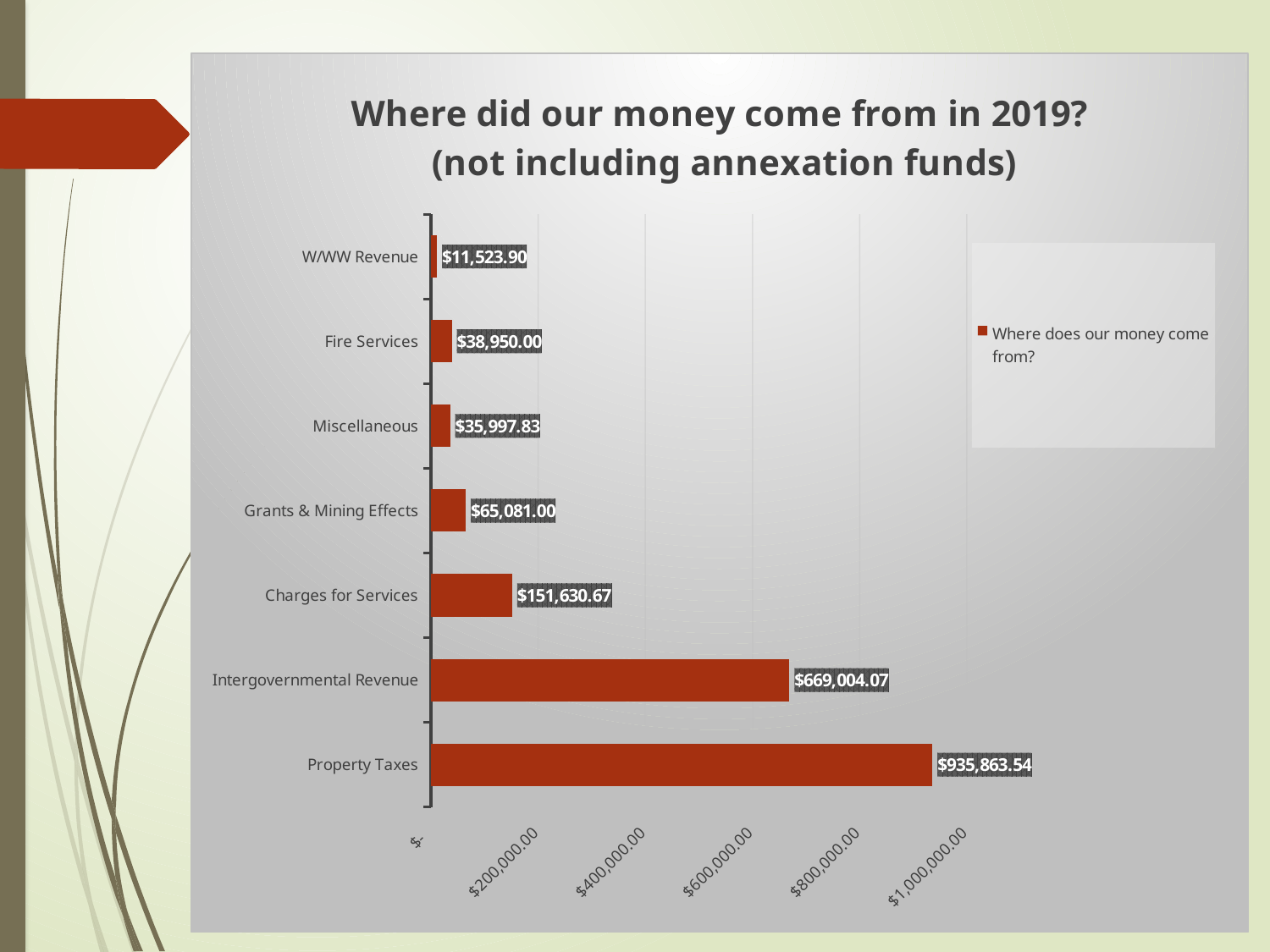
Which category has the highest value? Property Taxes Which is larger, Grants & Mining Effects or Charges for Services? Charges for Services What is the value for W/WW Revenue? $11,523.90 What kind of chart is shown on the slide? Bar chart Which category has the lowest value? W/WW Revenue What is the difference between Charges for Services and Grants & Mining Effects? $86,549.67 What is the value for Intergovernmental Revenue? $669,004.07 What is the difference between Property Taxes and Intergovernmental Revenue? $266,859.47 What is the value for Property Taxes? $935,863.54 What is the value for Charges for Services? $151,630.67 How many categories are shown in the chart? 7 Is the value for Intergovernmental Revenue greater or less than $600,000.00? greater